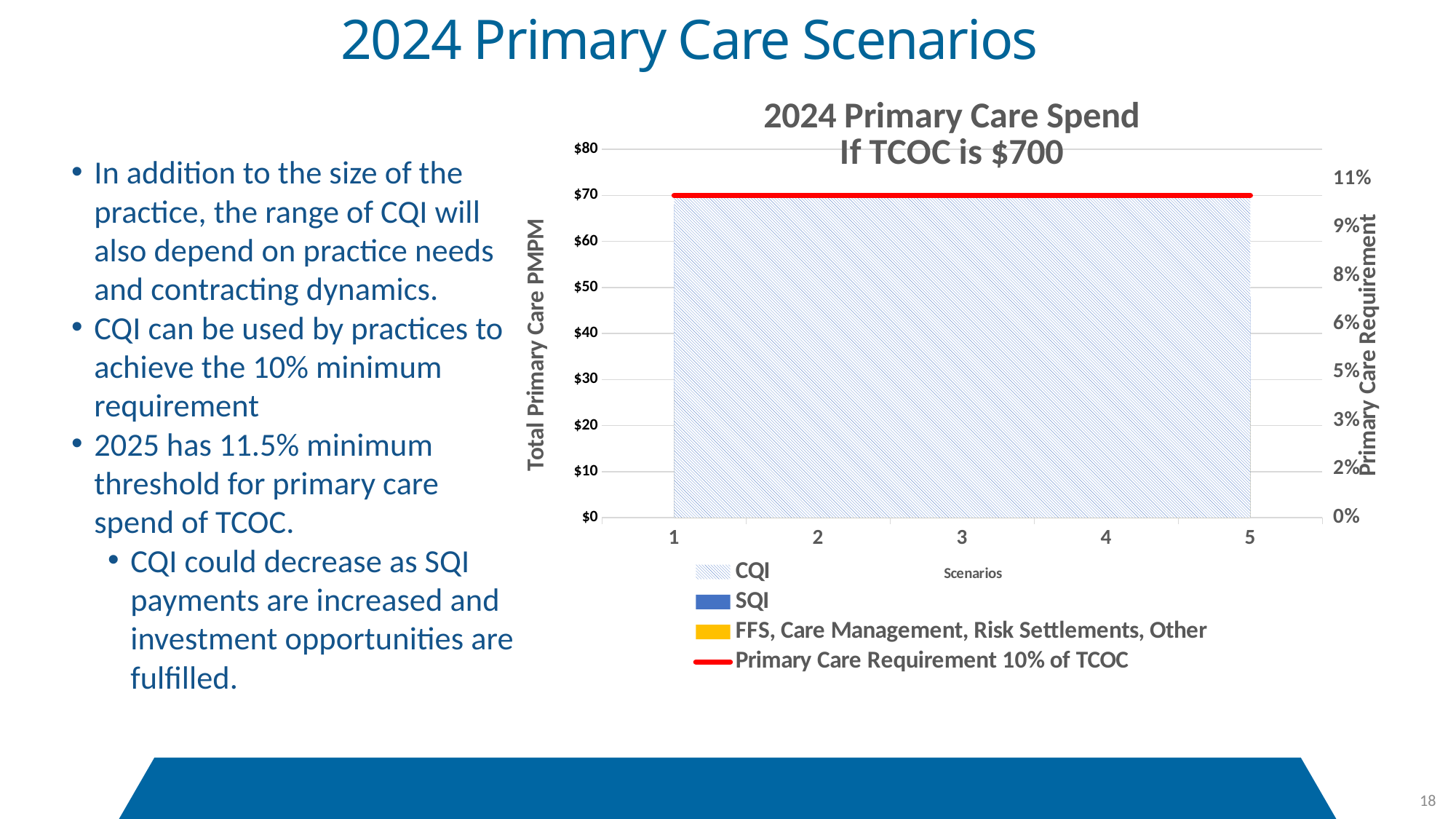
Does the Primary Care Requirement line rise, fall, or stay flat across scenarios 1 to 5? stays flat How many series does the chart legend list? 4 What kind of chart is shown? combination area and line chart What is the label of the left vertical axis? Total Primary Care PMPM What is the title of the chart? 2024 Primary Care Spend If TCOC is $700 How many scenarios are shown along the x axis? 5 Is the Primary Care Requirement line greater or less than $80? less Is the CQI value at scenario 3 greater or less than $40? greater Is the CQI value at scenario 1 greater or less than $60? greater What value does the Primary Care Requirement 10% of TCOC line sit at on the left axis? $70